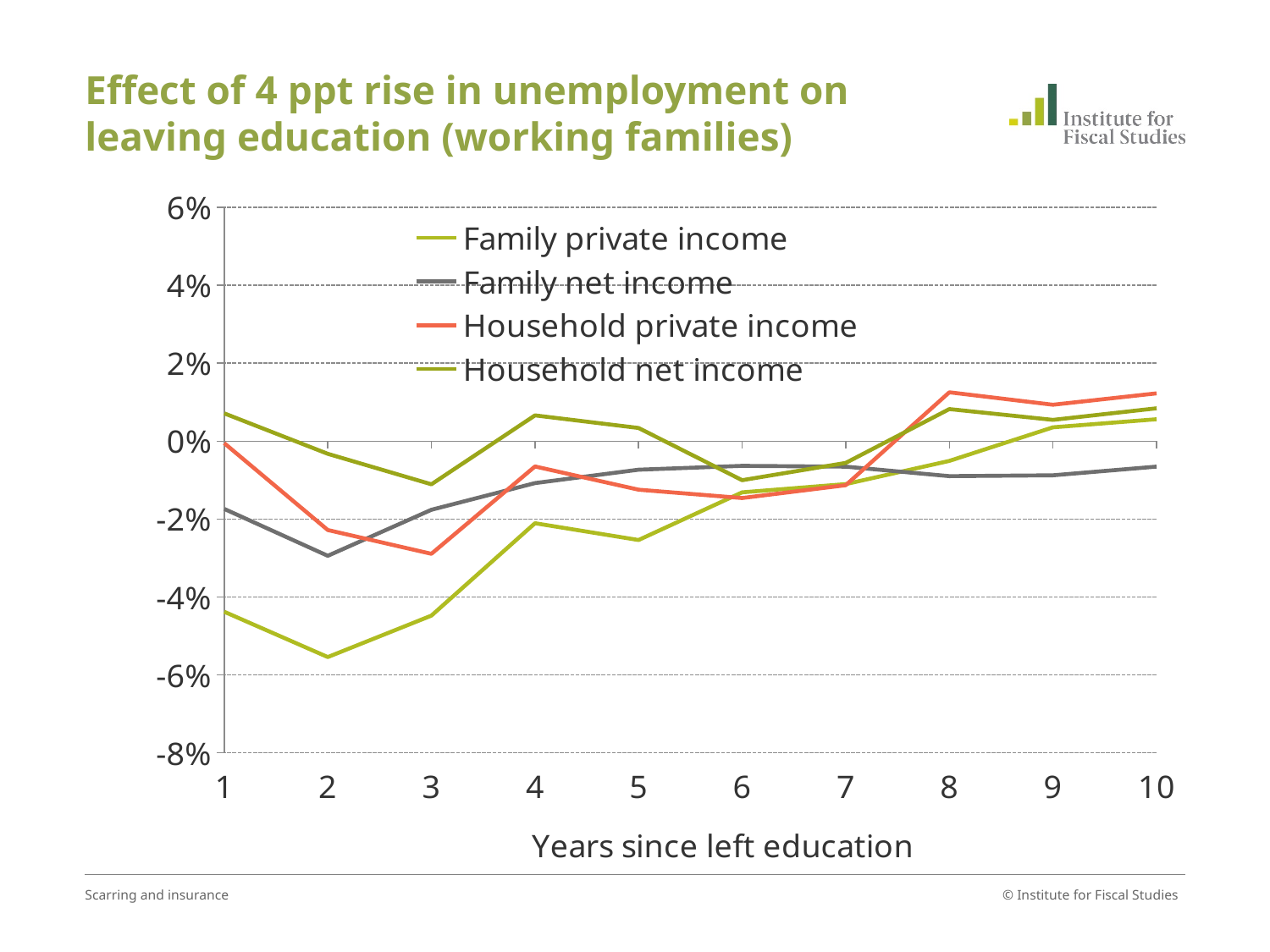
How many points are shown along the x axis (years since left education)? 10 What is the title of the x axis? Years since left education Is the value for Household private income at year 8 greater or less than 0%? greater How many series does the legend list? 4 Does the Family private income line rise or fall overall from year 1 to year 10? Rise Is the value for Family net income at year 2 greater or less than -2%? less At which year does Family private income reach its lowest value? 2 At year 3, which is higher: Family private income or Family net income? Family net income Is the value for Family private income at year 2 greater or less than -4%? less Which series has the highest value at year 1? Household net income What type of chart is shown on the slide? Line chart Which series has the lowest value at year 2? Family private income